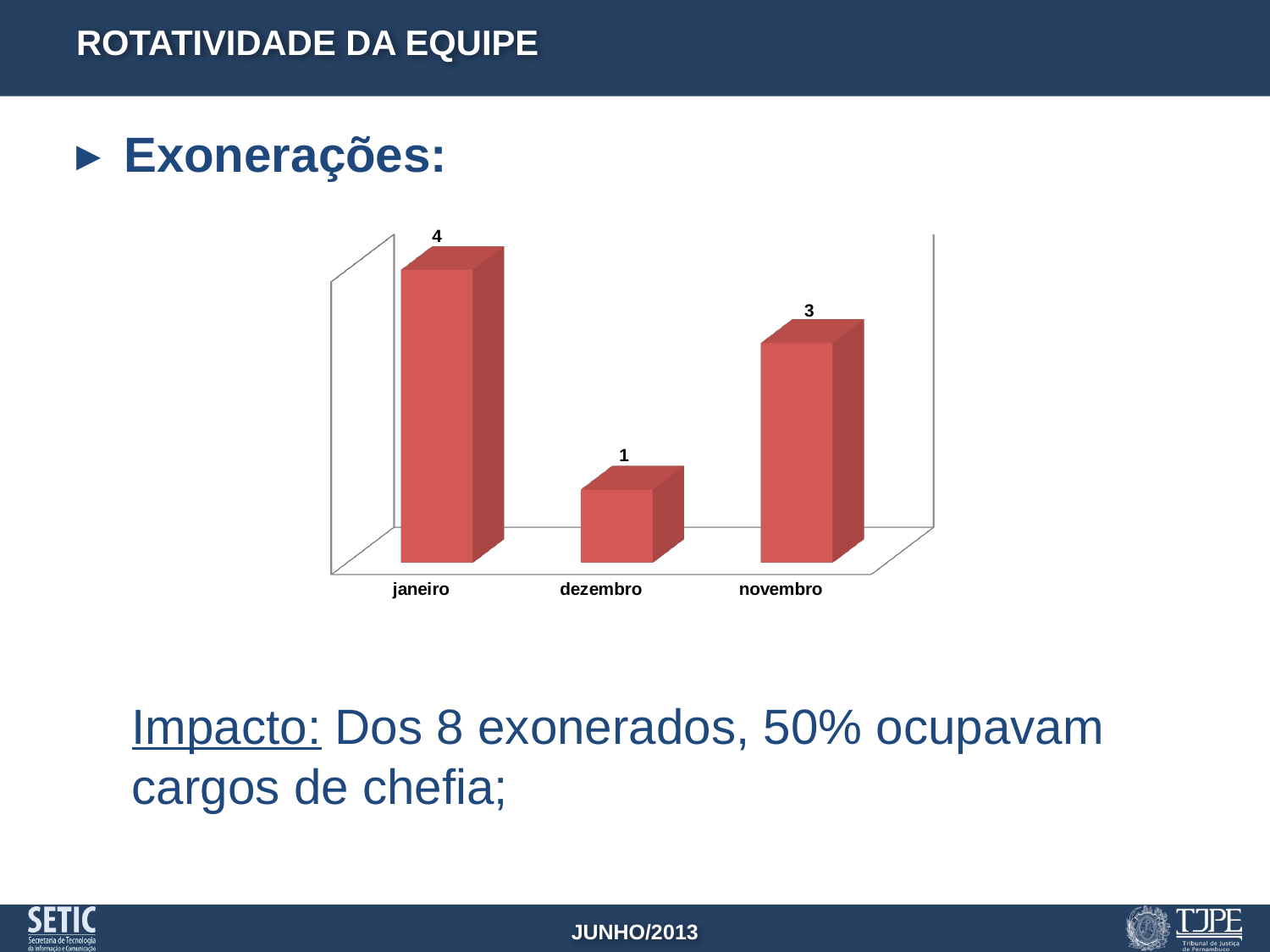
What is the value for dezembro? 1 What is the value for novembro? 3 Which month has the lowest value? dezembro What kind of chart is shown on the slide? bar chart What is the difference between the values for janeiro and dezembro? 3 What is the difference between the values for novembro and dezembro? 2 How many categories are shown on the x axis? 3 What is the value for janeiro? 4 What colour are the bars in the chart? red Which is larger, the value for janeiro or the value for novembro? janeiro What is the total of the three values shown in the chart? 8 Which month has the highest value? janeiro